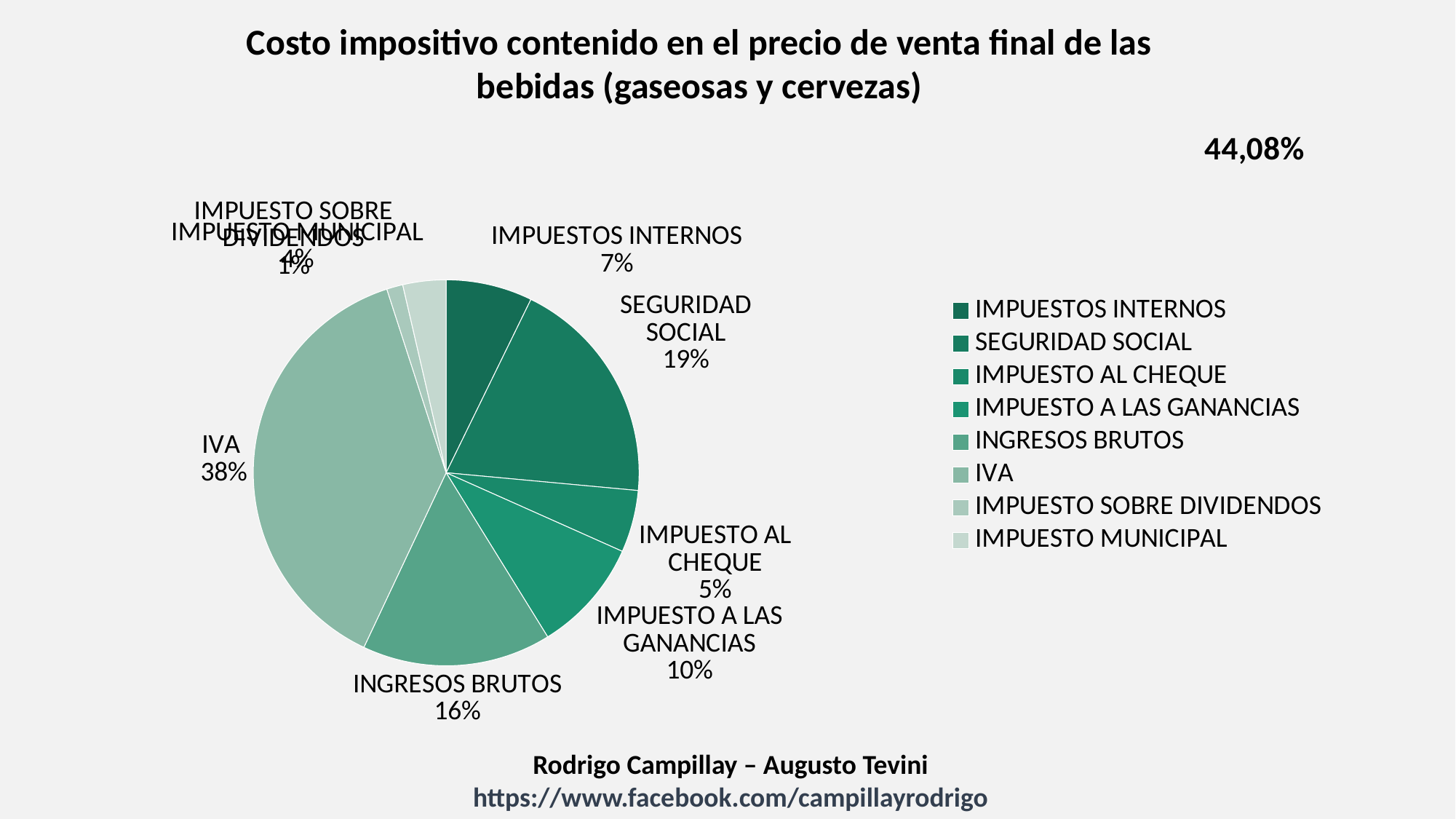
What total percentage figure is printed at the top right of the chart? 44,08% How many entries does the legend list? 8 What is the value shown for SEGURIDAD SOCIAL? 19% Which category has the largest slice of the pie? IVA What is the value shown for INGRESOS BRUTOS? 16% What share of the pie does IVA represent? 38% What kind of chart is shown on the slide? pie chart What is the value shown for IMPUESTOS INTERNOS? 7% Which is larger, INGRESOS BRUTOS or IMPUESTO A LAS GANANCIAS? INGRESOS BRUTOS What is the difference in percentage points between IVA and SEGURIDAD SOCIAL? 19 What is the value shown for IMPUESTO A LAS GANANCIAS? 10% What is the value shown for IMPUESTO AL CHEQUE? 5%